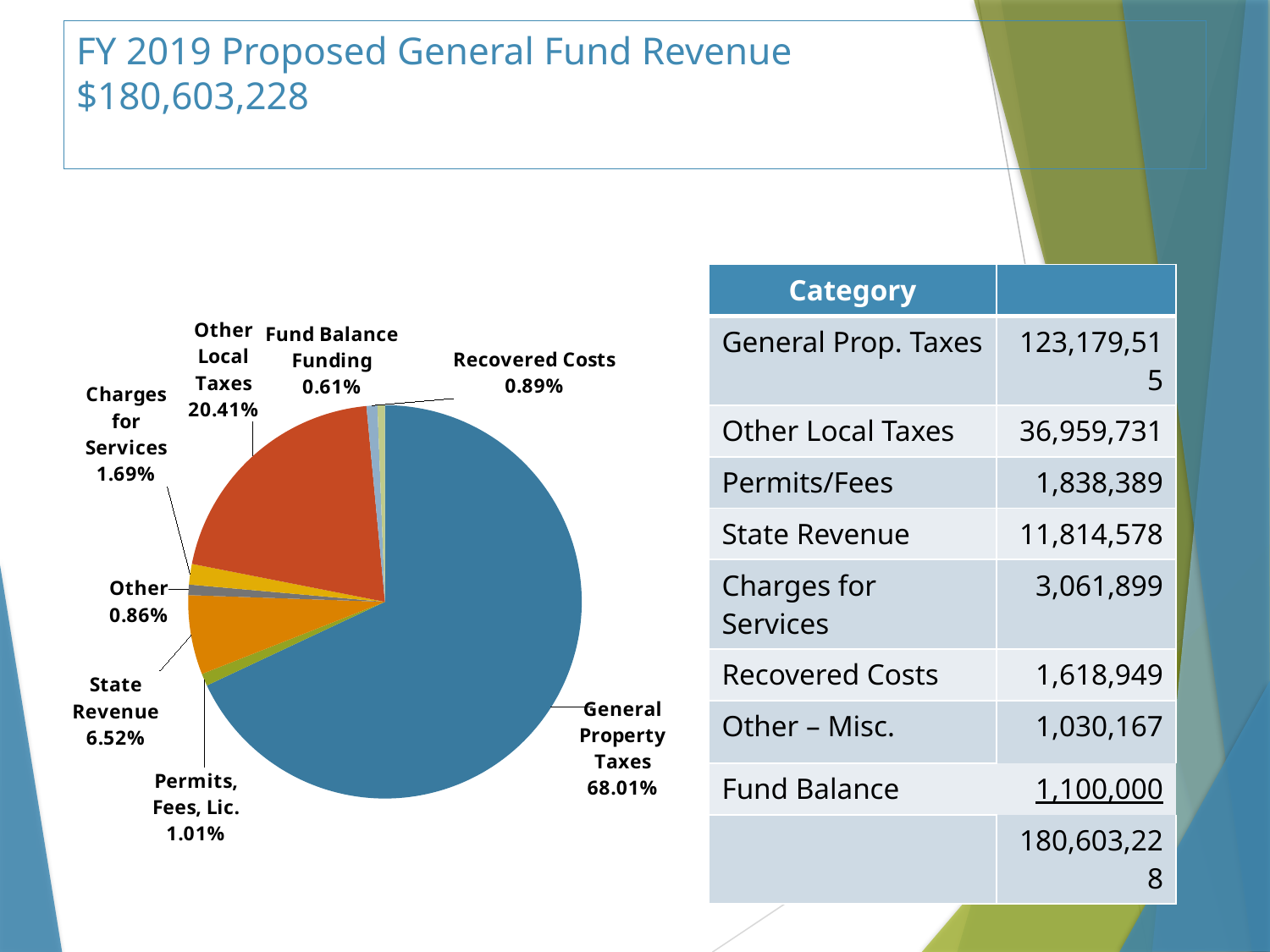
Which category has the smallest slice of the pie? Fund Balance Funding What percentage is shown for Recovered Costs? 0.89% What percentage is shown for State Revenue? 6.52% What percentage is shown for Other Local Taxes? 20.41% What share of the pie does General Property Taxes represent? 68.01% What is the title of the slide containing the chart? FY 2019 Proposed General Fund Revenue $180,603,228 What percentage is shown for Fund Balance Funding? 0.61% What is the difference in percentage points between General Property Taxes and Other Local Taxes? 47.60 What type of chart is shown on the slide? Pie chart Which category has the largest slice of the pie? General Property Taxes Which is larger, Charges for Services or Permits, Fees, Lic.? Charges for Services How many slices does the pie chart have? 8